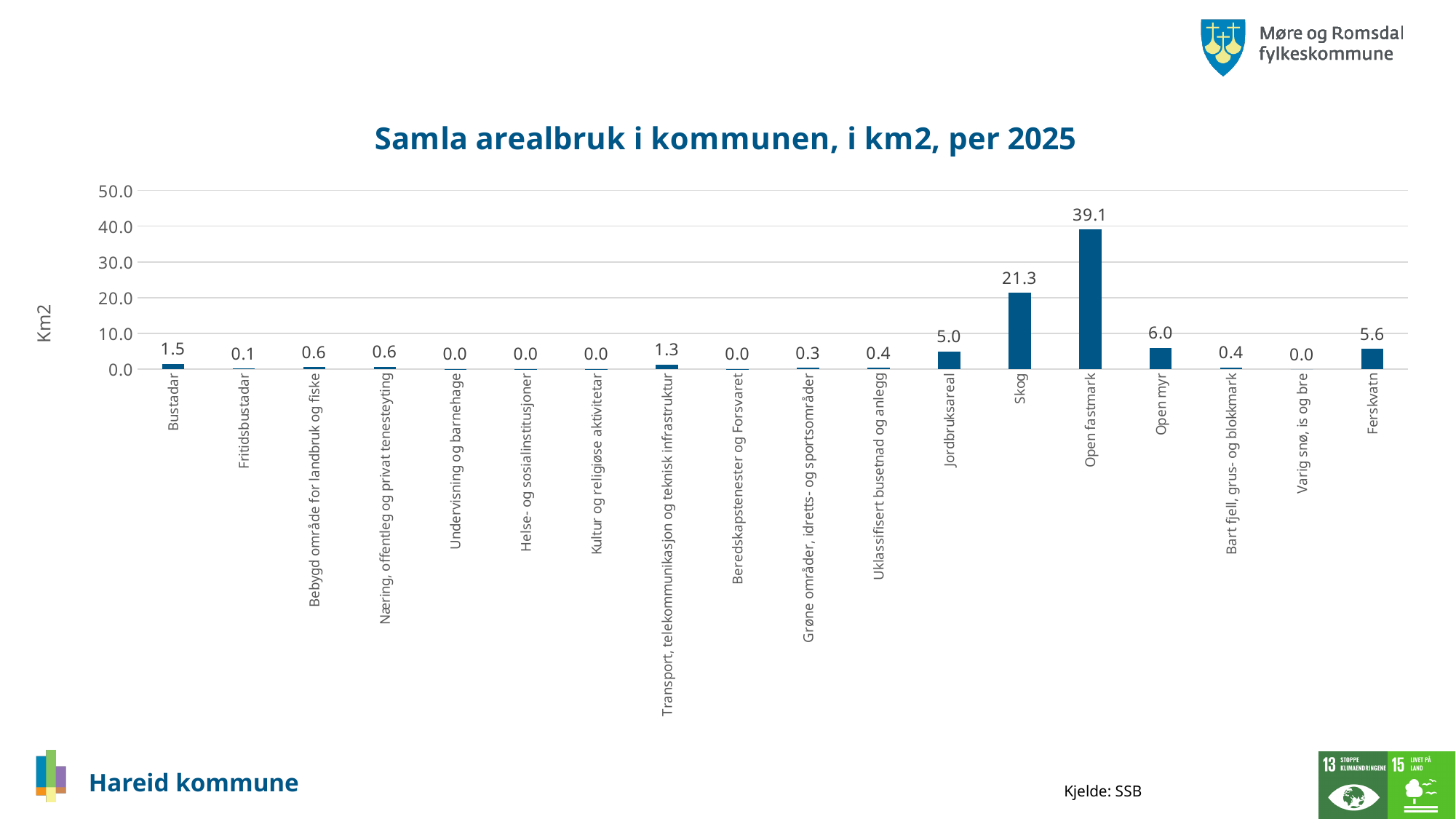
Is the value for Skog greater or less than 20.0? greater What is the value for Ferskvatn? 5.6 Which category has the highest value? Open fastmark What is the value for Jordbruksareal? 5.0 What is the value for Open fastmark? 39.1 How many categories are shown on the x axis? 18 What is the value for Skog? 21.3 What kind of chart is shown on the slide? bar chart What is the difference between the values for Open fastmark and Skog? 17.8 What is the title of the chart? Samla arealbruk i kommunen, i km2, per 2025 What is the value for Bustadar? 1.5 Which is larger, the value for Open myr or the value for Ferskvatn? Open myr